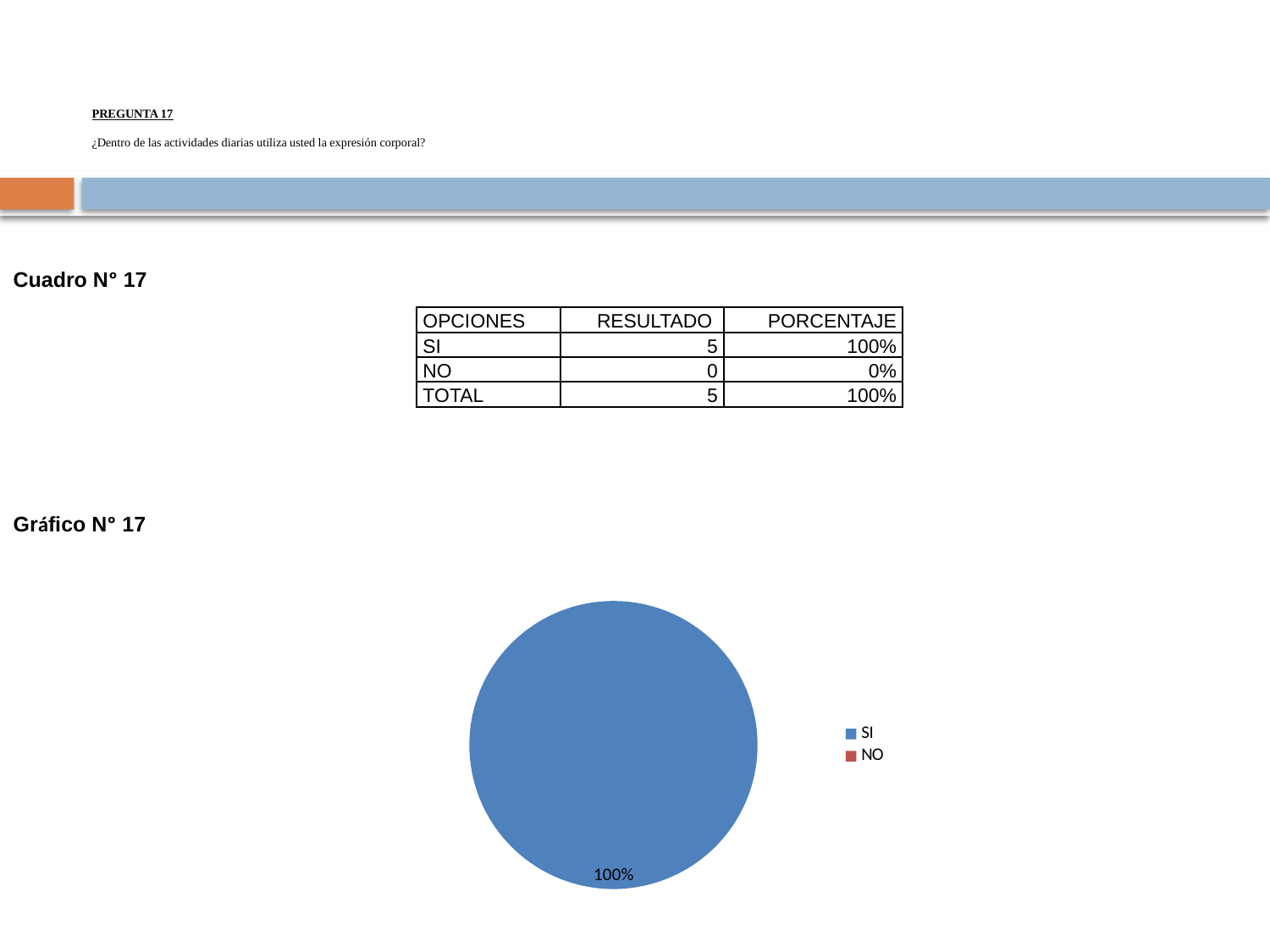
What kind of chart is shown on the slide? pie chart What colour is the SI slice in the pie chart? blue How many entries does the legend of the pie chart list? 2 What percentage is shown on the data label of the pie chart? 100% Which is larger in the pie chart, SI or NO? SI What share of the pie does the SI slice represent? 100% What are the two legend entries of the pie chart? SI and NO Which category takes up the whole pie chart? SI Which category has the smallest share of the pie chart? NO